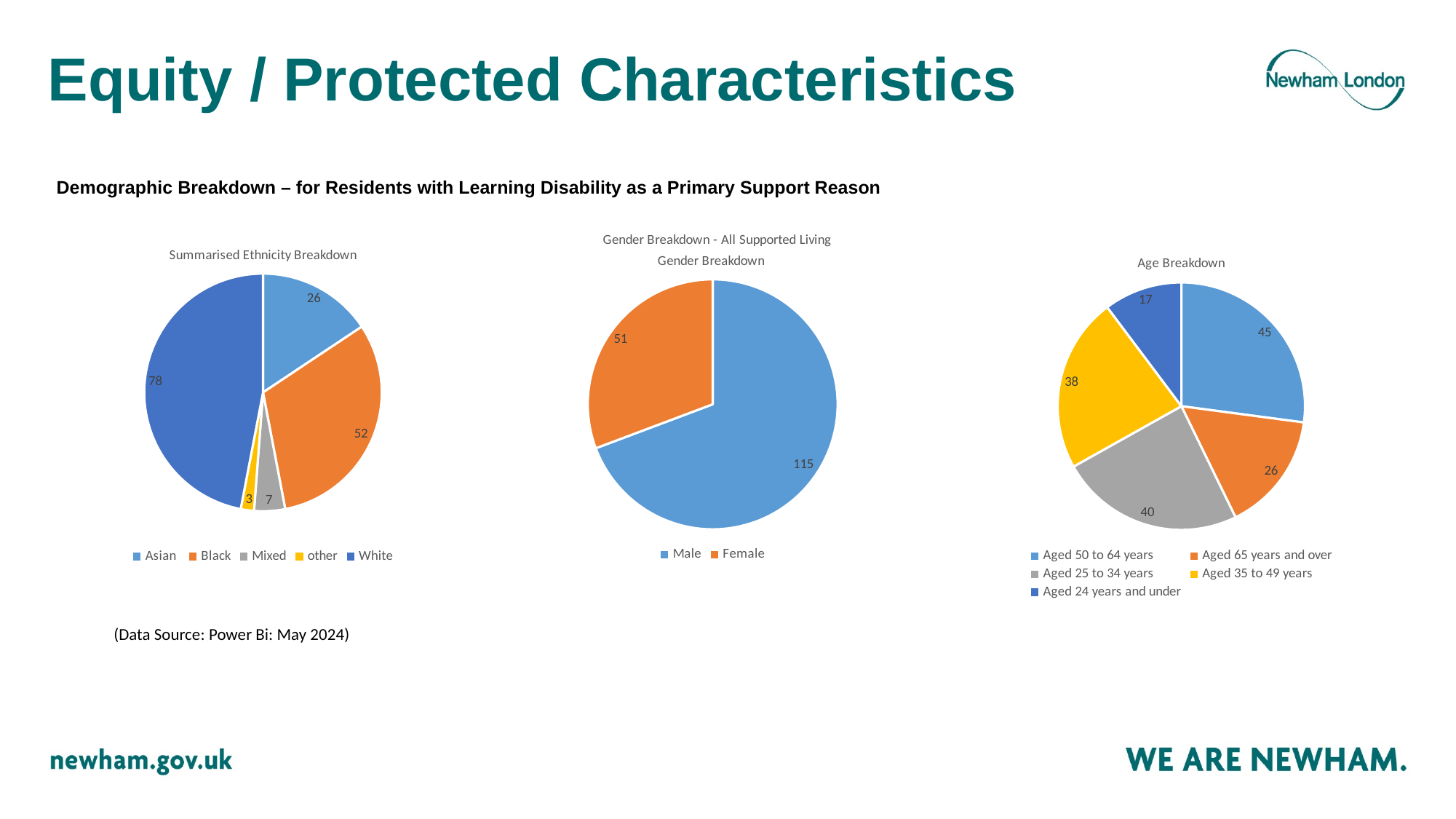
In the Gender Breakdown chart, what is the value for Female? 51 In the Summarised Ethnicity Breakdown chart, what is the value for Black? 52 In the Age Breakdown chart, which age group has the smallest value? Aged 24 years and under What type of chart is the Age Breakdown chart? Pie chart How many categories does the Summarised Ethnicity Breakdown chart show? 5 In the Gender Breakdown chart, what is the difference between the Male and Female values? 64 In the Summarised Ethnicity Breakdown chart, which category has the largest value? White How many entries does the legend of the Age Breakdown chart list? 5 In the Summarised Ethnicity Breakdown chart, which category has the smallest value? other In the Age Breakdown chart, what is the value for Aged 35 to 49 years? 38 In the Gender Breakdown chart, which is larger, Male or Female? Male In the Summarised Ethnicity Breakdown chart, what is the difference between the White and Asian values? 52